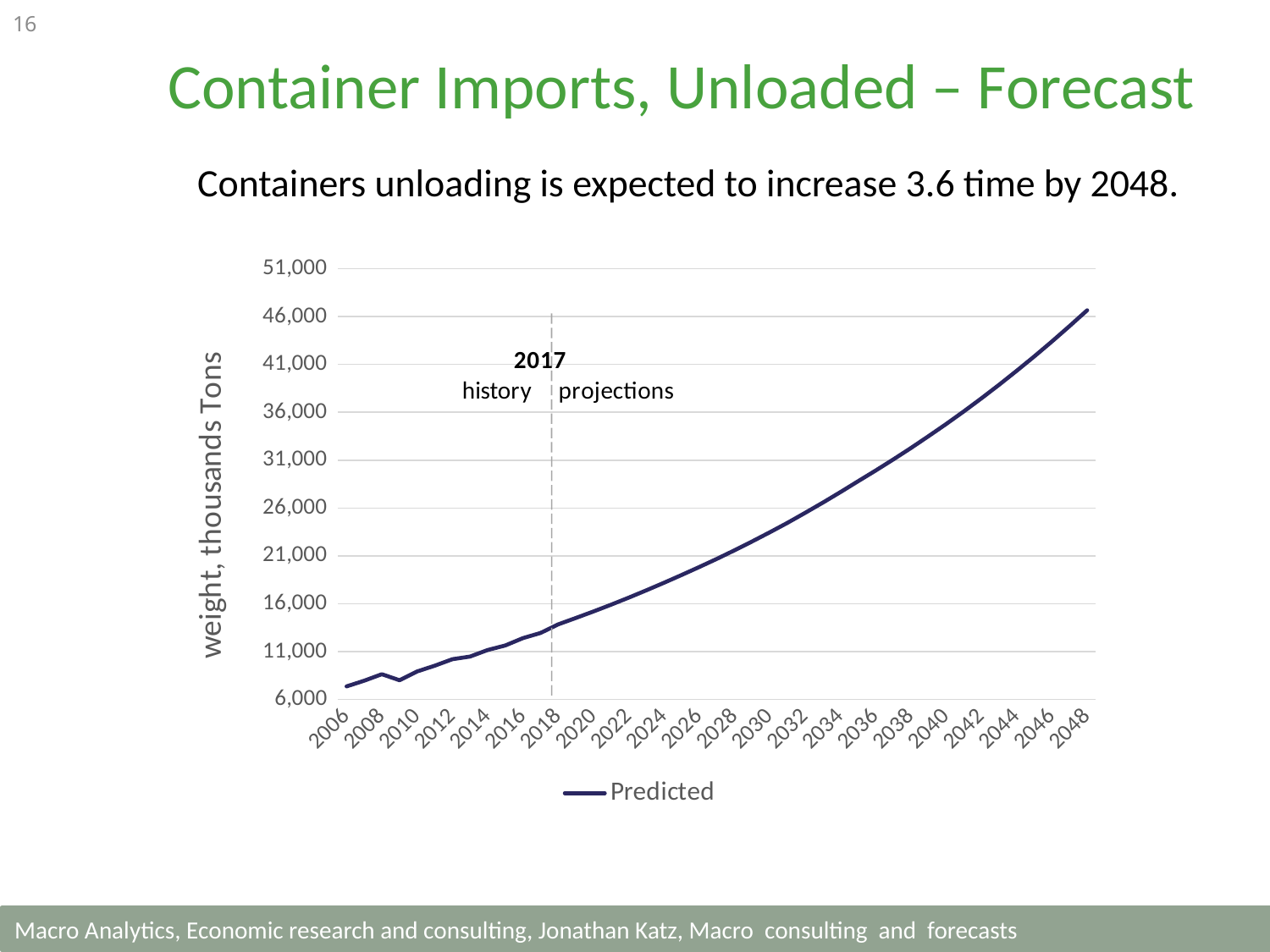
How many series does the legend list? 1 Which year has the larger value, 2020 or 2040? 2040 Is the value for 2048 greater or less than 41,000? greater Which year has the highest value? 2048 Is the value for 2006 greater or less than 11,000? less Which year has the lowest value? 2006 Is the value for 2040 greater or less than 31,000? greater Do the values rise or fall from 2006 to 2048? rise What kind of chart is shown on the slide? line chart What is the name of the series shown in the legend? Predicted What is the label on the vertical axis? weight, thousands Tons